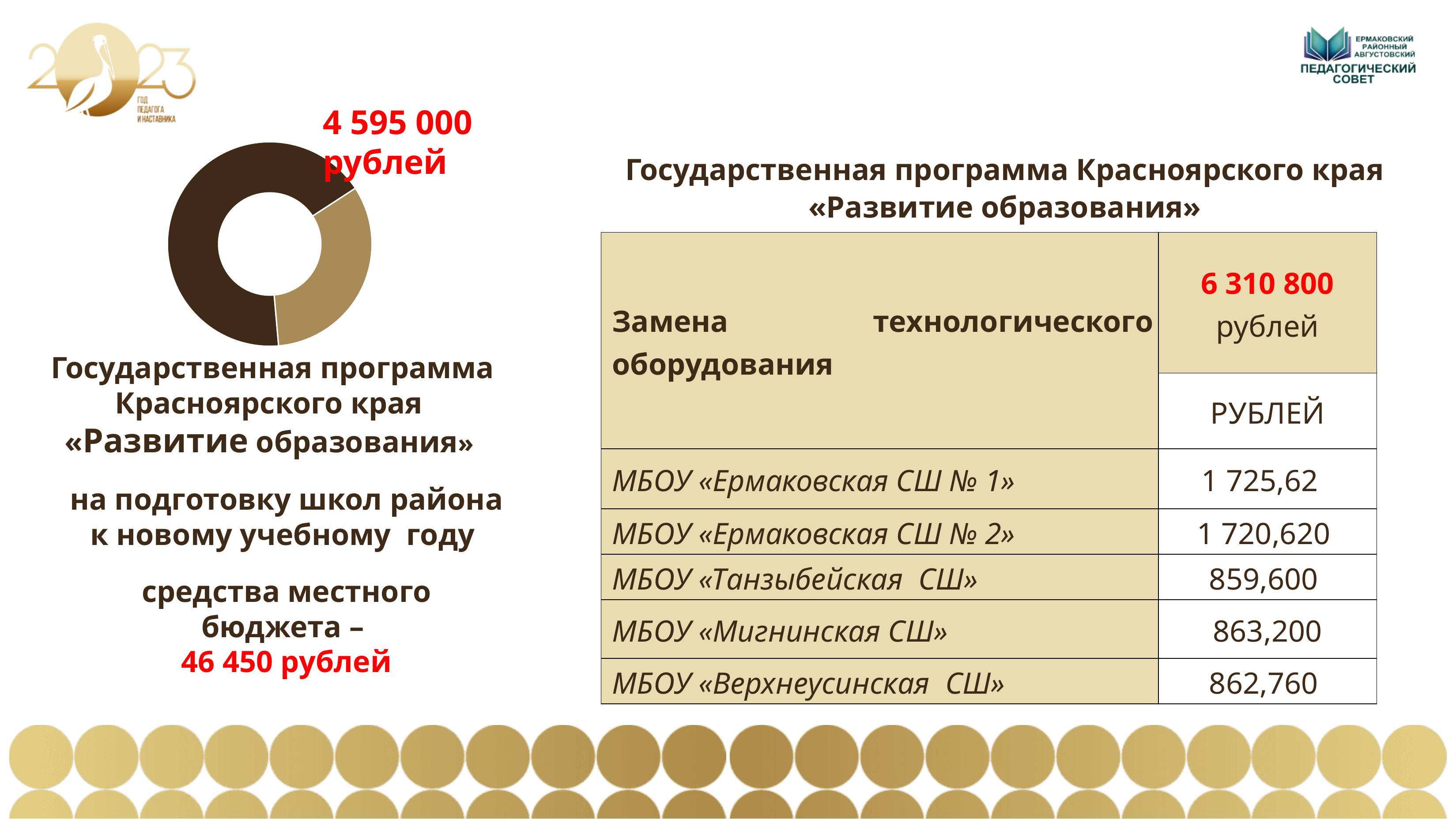
In the doughnut chart on the left, which slice is larger, the dark brown one or the tan one? the dark brown one What two colours are used for the slices of the doughnut chart on the left? dark brown and tan How many slices does the doughnut chart on the left of the slide have? 2 In the doughnut chart on the left, is the dark brown slice more or less than half of the ring? more What amount in red is printed next to the doughnut chart on the left? 4 595 000 рублей What kind of chart is shown on the left of the slide? doughnut (pie) chart